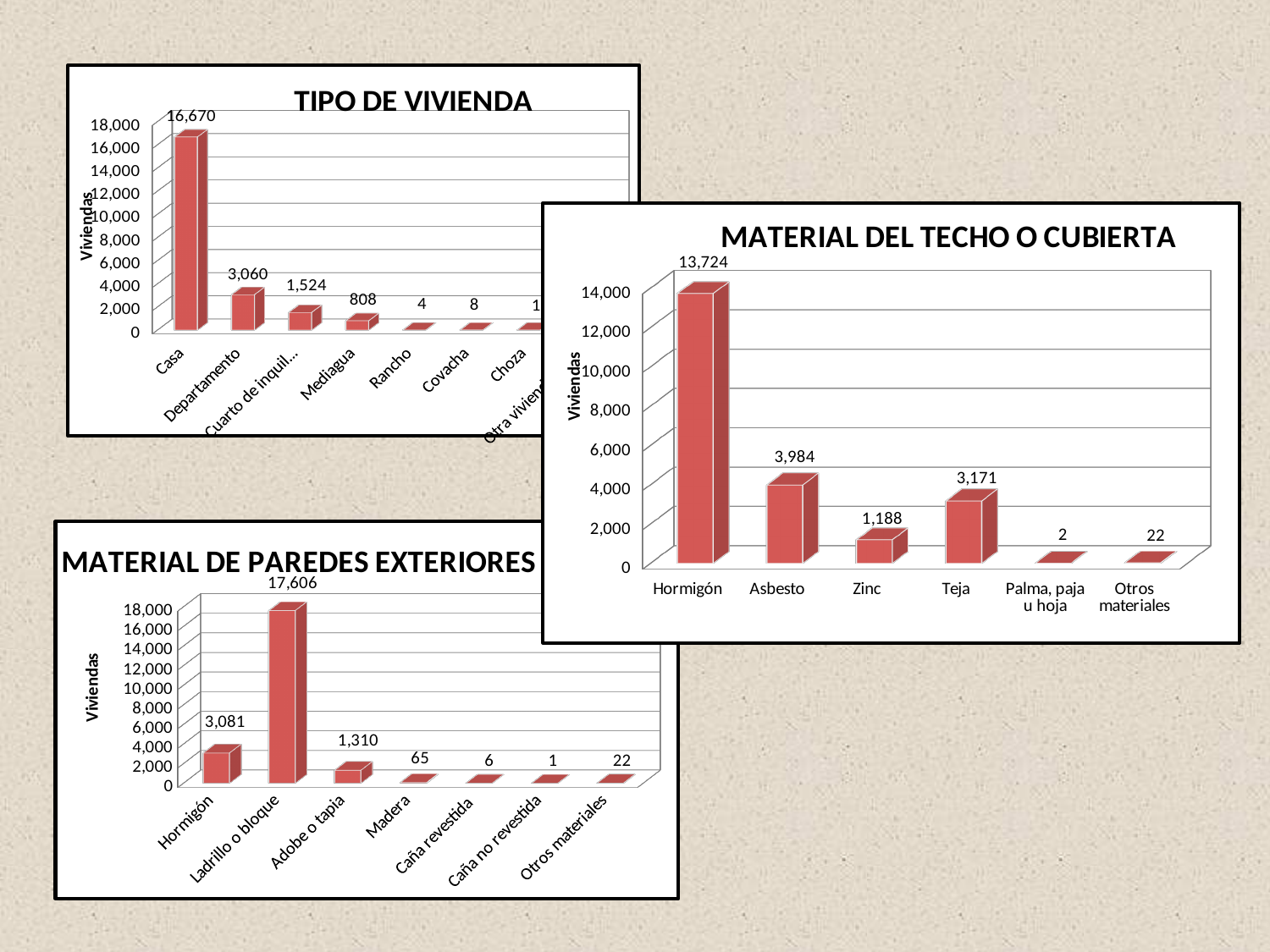
In the TIPO DE VIVIENDA chart, what is the value for Casa? 16,670 In the MATERIAL DEL TECHO O CUBIERTA chart, what is the value for Hormigón? 13,724 In the MATERIAL DEL TECHO O CUBIERTA chart, how many categories are shown on the x axis? 6 In the TIPO DE VIVIENDA chart, what is the difference between Departamento and Mediagua? 2,252 In the MATERIAL DEL TECHO O CUBIERTA chart, which is larger, Zinc or Teja? Teja In the MATERIAL DE PAREDES EXTERIORES chart, how many categories are shown on the x axis? 7 What kind of chart is the MATERIAL DEL TECHO O CUBIERTA chart? Bar chart In the MATERIAL DE PAREDES EXTERIORES chart, what is the value for Madera? 65 In the MATERIAL DE PAREDES EXTERIORES chart, which category has the highest value? Ladrillo o bloque In the MATERIAL DE PAREDES EXTERIORES chart, what is the value for Ladrillo o bloque? 17,606 In the MATERIAL DEL TECHO O CUBIERTA chart, which category has the lowest value? Palma, paja u hoja In the MATERIAL DEL TECHO O CUBIERTA chart, what is the difference between Asbesto and Teja? 813